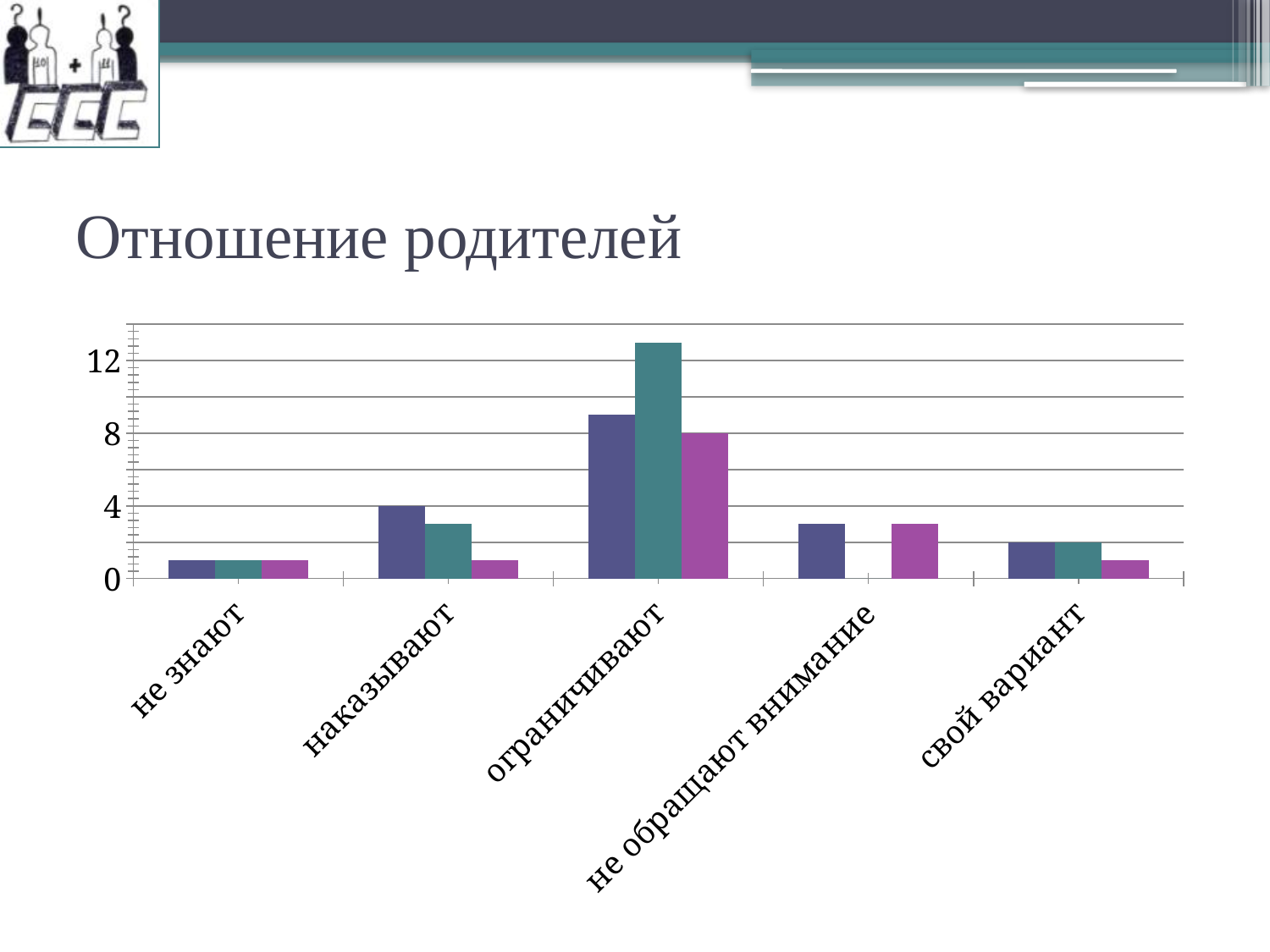
For the category 'наказывают', which bar is taller: the dark blue bar or the magenta bar? the dark blue bar How many bars (series) are plotted for the category 'ограничивают'? 3 What is the title of the chart? Отношение родителей Is the value of the dark blue bar for 'ограничивают' greater or less than 8? greater Which category has the tallest bar in the chart? ограничивают Is the value of the dark blue bar for 'не обращают внимание' greater or less than 4? less How many categories are shown on the x axis of the chart? 5 What kind of chart is shown on the slide? bar chart For the category 'ограничивают', which bar is taller: the teal bar or the magenta bar? the teal bar Is the value of the magenta bar for 'наказывают' greater or less than 4? less Which category has no teal bar at all? не обращают внимание